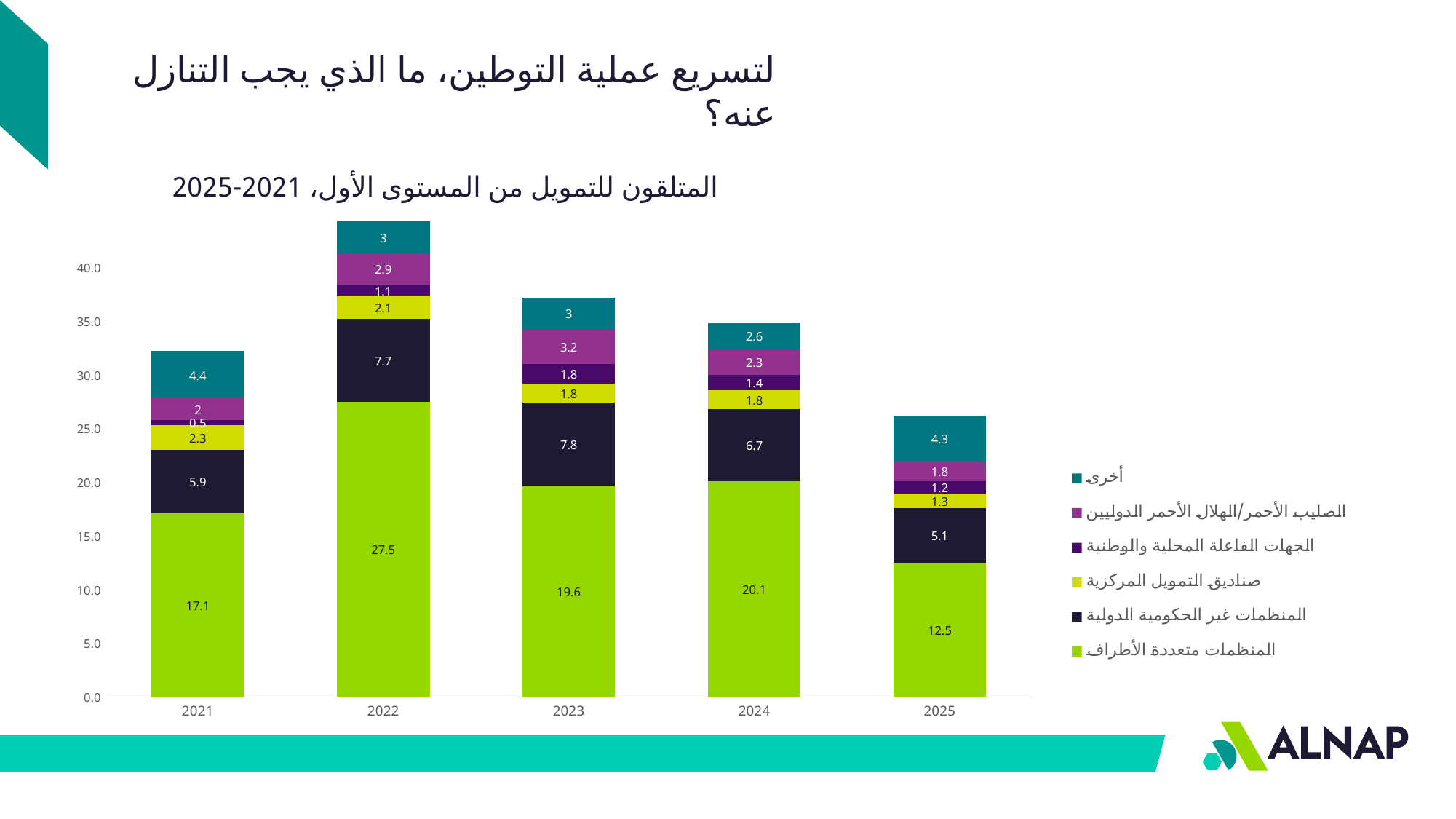
In which year is the المنظمات متعددة الأطراف segment the smallest? 2025 What is the value of the المنظمات متعددة الأطراف segment for 2022? 27.5 What is the difference between the المنظمات متعددة الأطراف values for 2024 and 2025? 7.6 Is the total height of the 2022 bar greater or less than 40.0? greater What is the value of the المنظمات غير الحكومية الدولية segment for 2023? 7.8 What is the value of the أخرى segment for 2025? 4.3 Which is larger: the الصليب الأحمر/الهلال الأحمر الدوليين value for 2023 or for 2024? 2023 What is the total of the stacked bar for 2021? 32.2 What type of chart is shown on the slide? stacked bar chart How many series does the chart legend list? 6 How many years (categories) are shown on the x axis of the chart? 5 In which year is the المنظمات متعددة الأطراف segment the largest? 2022